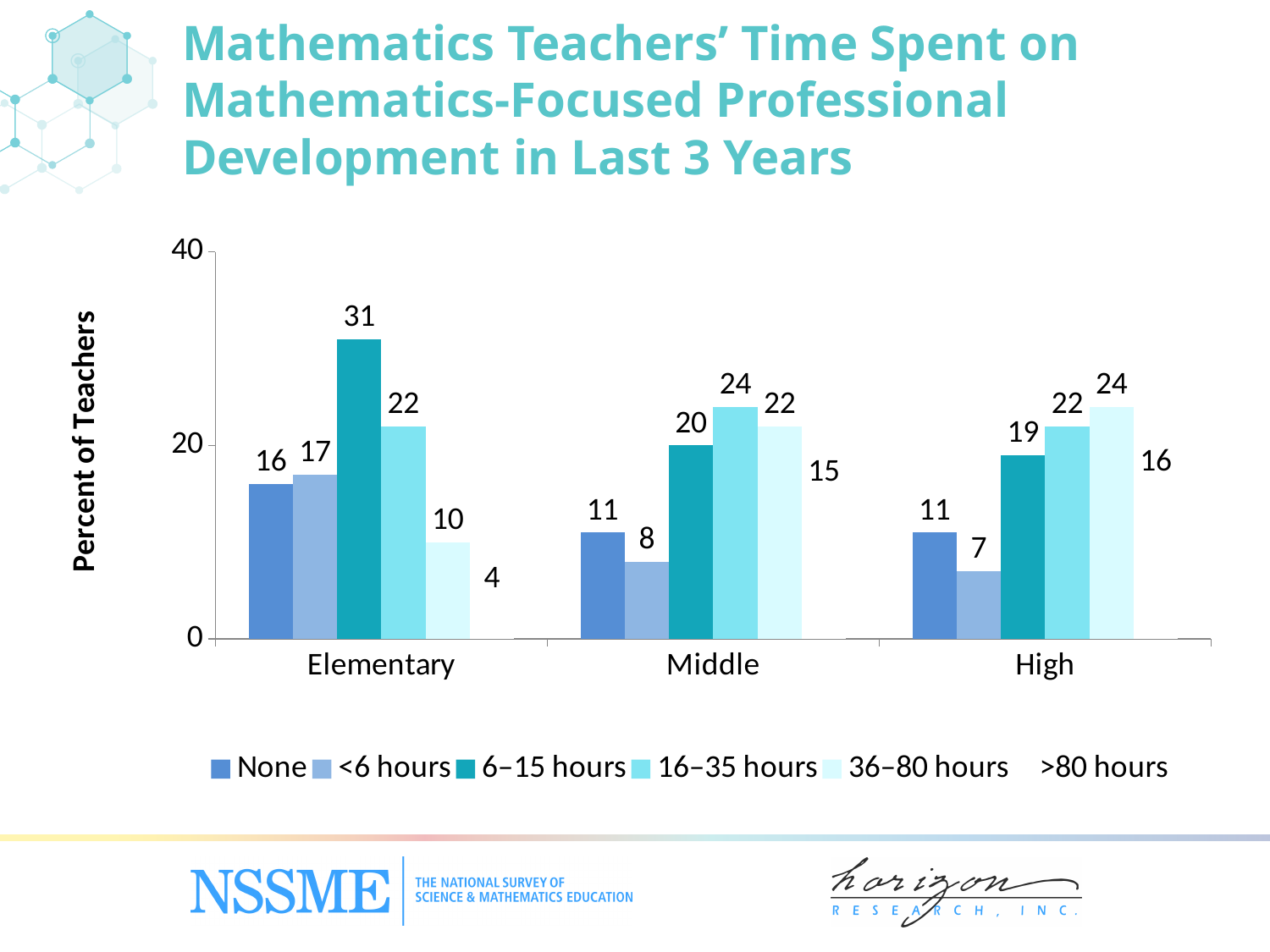
What is the label of the vertical axis? Percent of Teachers How many series does the legend list? 6 Which is larger: the percentage of middle school teachers with >80 hours or the percentage of high school teachers with >80 hours? High school teachers (16) What percent of middle school mathematics teachers spent 16–35 hours on professional development? 24 Which grade level has the highest percentage of teachers in the 36–80 hours category? High How many grade-level categories are shown on the x axis? 3 What percent of high school mathematics teachers reported no mathematics-focused professional development (None)? 11 What is the difference between the percentage of elementary teachers and middle school teachers in the 6–15 hours category? 11 What percent of elementary mathematics teachers spent more than 80 hours on professional development? 4 What percent of elementary mathematics teachers spent 6–15 hours on mathematics-focused professional development? 31 What kind of chart is shown on the slide? Bar chart Which grade level has the lowest percentage of teachers in the <6 hours category? High